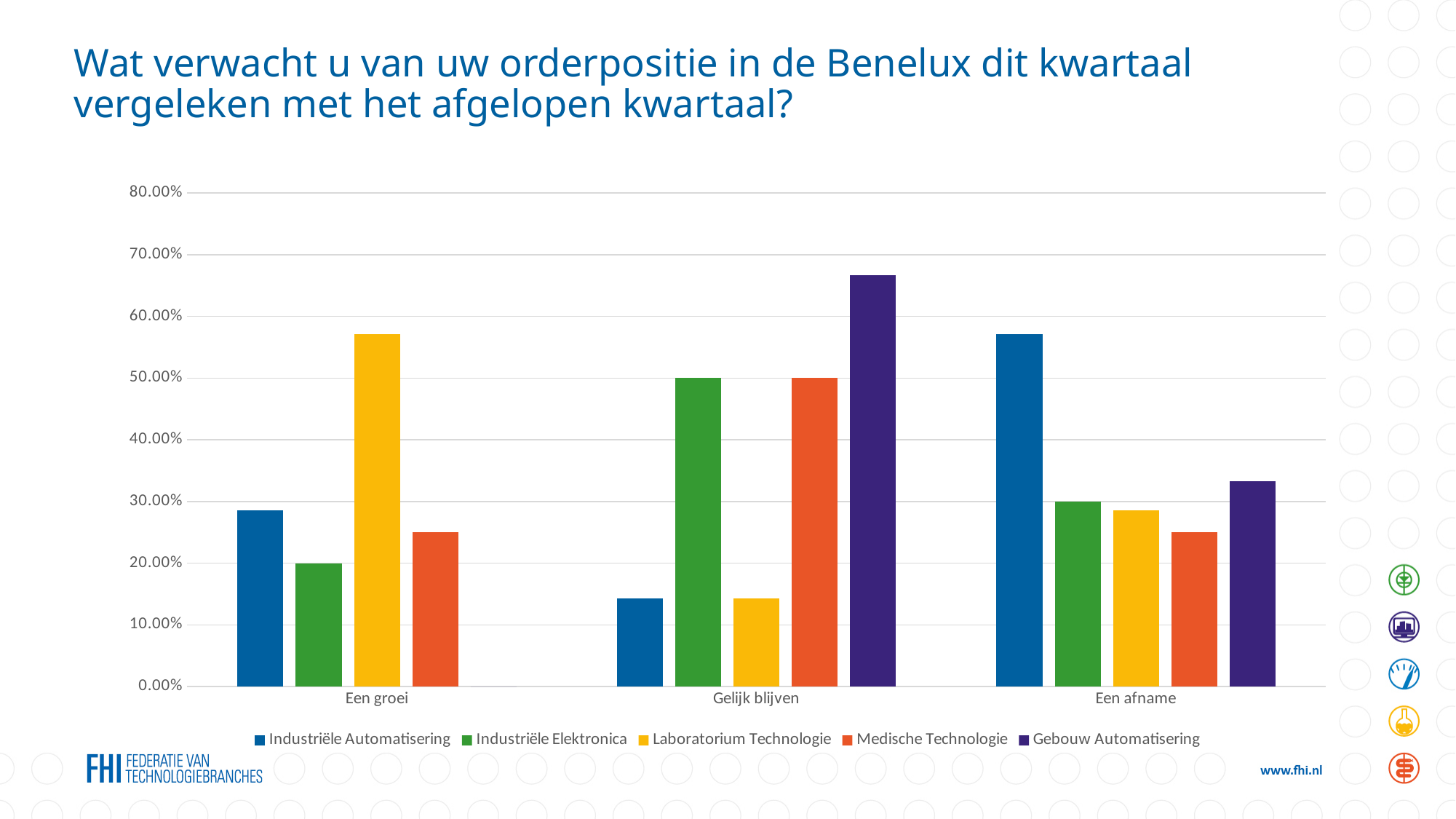
Which colour represents Medische Technologie in the legend? orange-red Which is larger: Laboratorium Technologie in 'Een groei' or Industriële Automatisering in 'Een groei'? Laboratorium Technologie in 'Een groei' Which series has the highest value in the 'Gelijk blijven' category? Gebouw Automatisering Is the value for Gebouw Automatisering in 'Gelijk blijven' greater or less than 60.00%? greater Is the value for Industriële Automatisering in 'Gelijk blijven' greater or less than 20.00%? less How many series does the legend list? 5 How many categories are shown on the x axis? 3 Which series has the lowest value in the 'Een afname' category? Medische Technologie Which is larger: Gebouw Automatisering in 'Een afname' or Industriële Elektronica in 'Een afname'? Gebouw Automatisering in 'Een afname' Which series has the highest value in the 'Een groei' category? Laboratorium Technologie Which series has the highest value in the 'Een afname' category? Industriële Automatisering What kind of chart is shown on the slide? bar chart